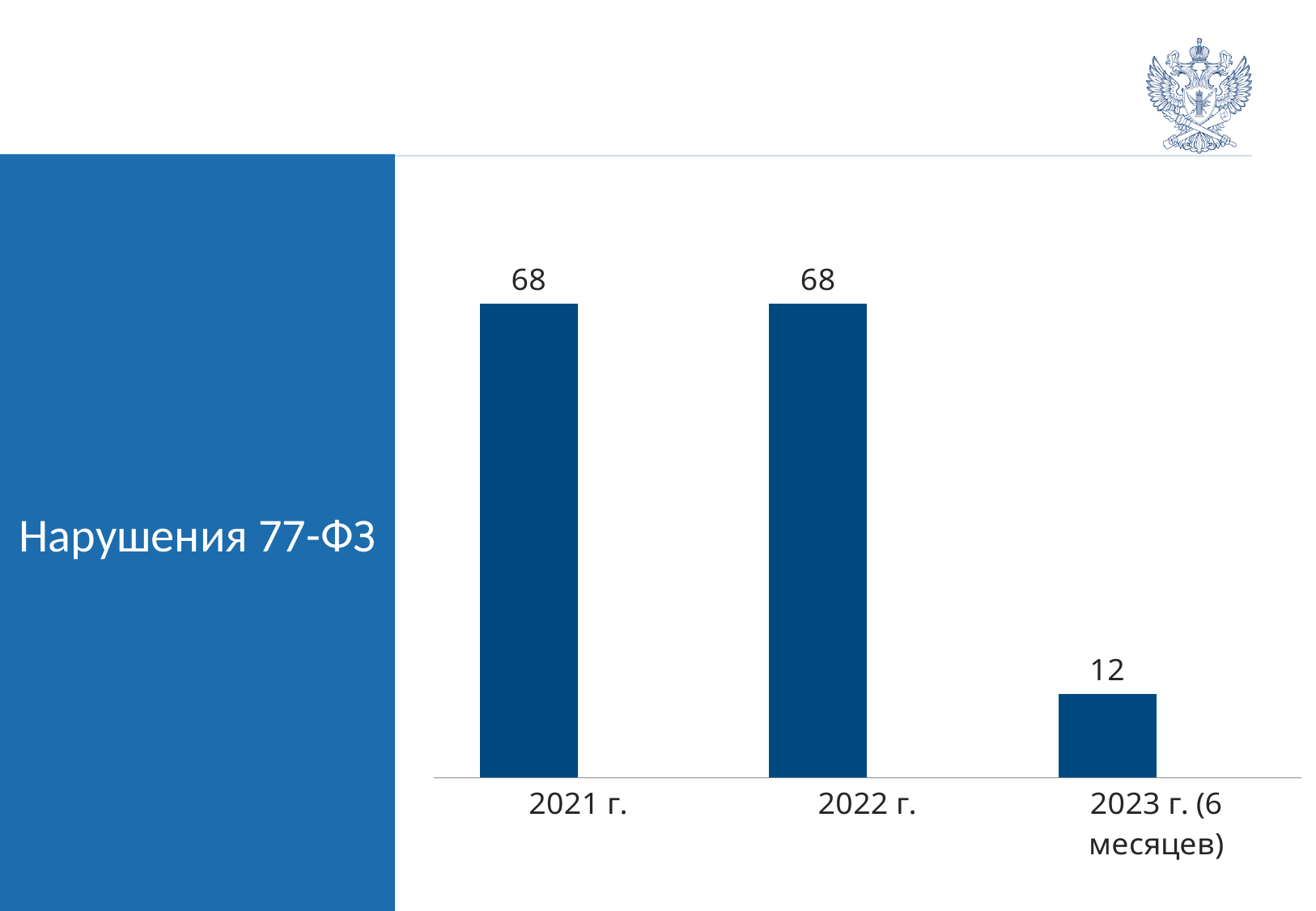
Do the values rise or fall from 2022 г. to 2023 г. (6 месяцев)? fall What colour are the bars in the chart? dark blue What is the value for 2023 г. (6 месяцев)? 12 How many categories are shown on the x axis? 3 What is the value for 2022 г.? 68 What is the difference between the values for 2021 г. and 2022 г.? 0 What is the difference between the values for 2022 г. and 2023 г. (6 месяцев)? 56 Which category has the lowest value? 2023 г. (6 месяцев) What is the title shown on the left panel of the slide? Нарушения 77-ФЗ Which is larger, the value for 2021 г. or the value for 2023 г. (6 месяцев)? 2021 г. What kind of chart is shown on the slide? bar chart What is the value for 2021 г.? 68